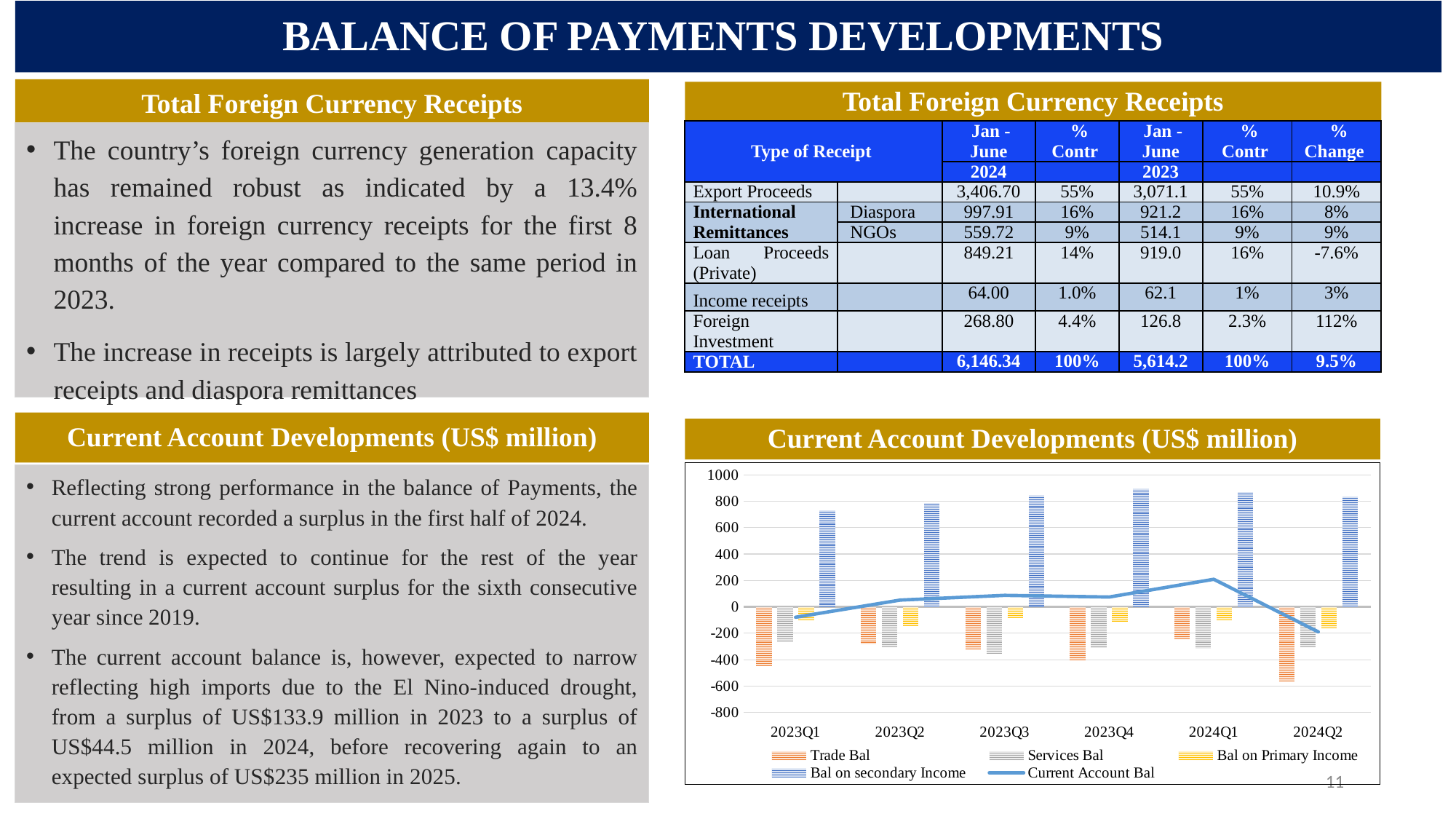
How many quarters are shown on the x axis of the Current Account Developments chart? 6 In the Current Account Developments chart, which quarter has the highest Current Account Bal? 2024Q1 In the Current Account Developments chart, is the value for Trade Bal in 2024Q2 greater or less than -400? less In the Current Account Developments chart, which series is shown as a solid blue line? Current Account Bal In the Current Account Developments chart, does the Current Account Bal line rise or fall from 2023Q1 to 2024Q1? rise In the Current Account Developments chart, is the value for Current Account Bal in 2024Q1 greater or less than 0? greater In the Current Account Developments chart, which quarter has the lowest Current Account Bal? 2024Q2 What kind of chart is the Current Account Developments (US$ million) chart? bar and line chart In the Current Account Developments chart, which quarter has the lowest (most negative) Trade Bal? 2024Q2 In the Current Account Developments chart, is the value for Bal on secondary Income in 2023Q1 greater or less than 600? greater How many series does the legend of the Current Account Developments chart list? 5